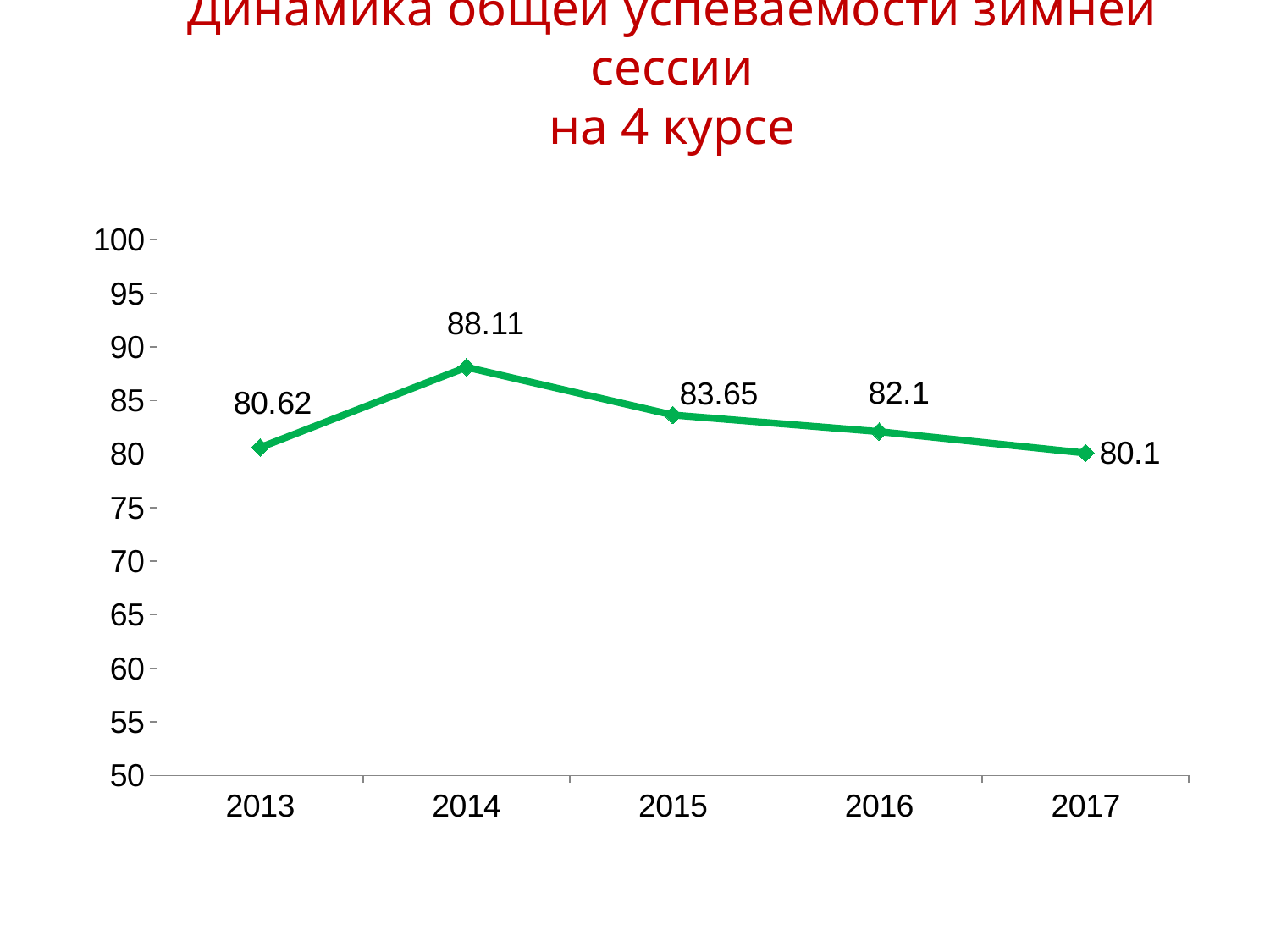
What is the value for 2014? 88.11 Which is larger, the value for 2015 or the value for 2016? 2015 What is the difference between the values for 2014 and 2015? 4.46 What is the value for 2013? 80.62 What is the value for 2017? 80.1 Which year has the lowest value? 2017 What is the difference between the values for 2013 and 2017? 0.52 Is the value for 2014 greater or less than 85? greater Which year has the highest value? 2014 What kind of chart is shown on the slide? line chart Do the values rise or fall from 2014 to 2017? fall How many years are plotted on the chart? 5